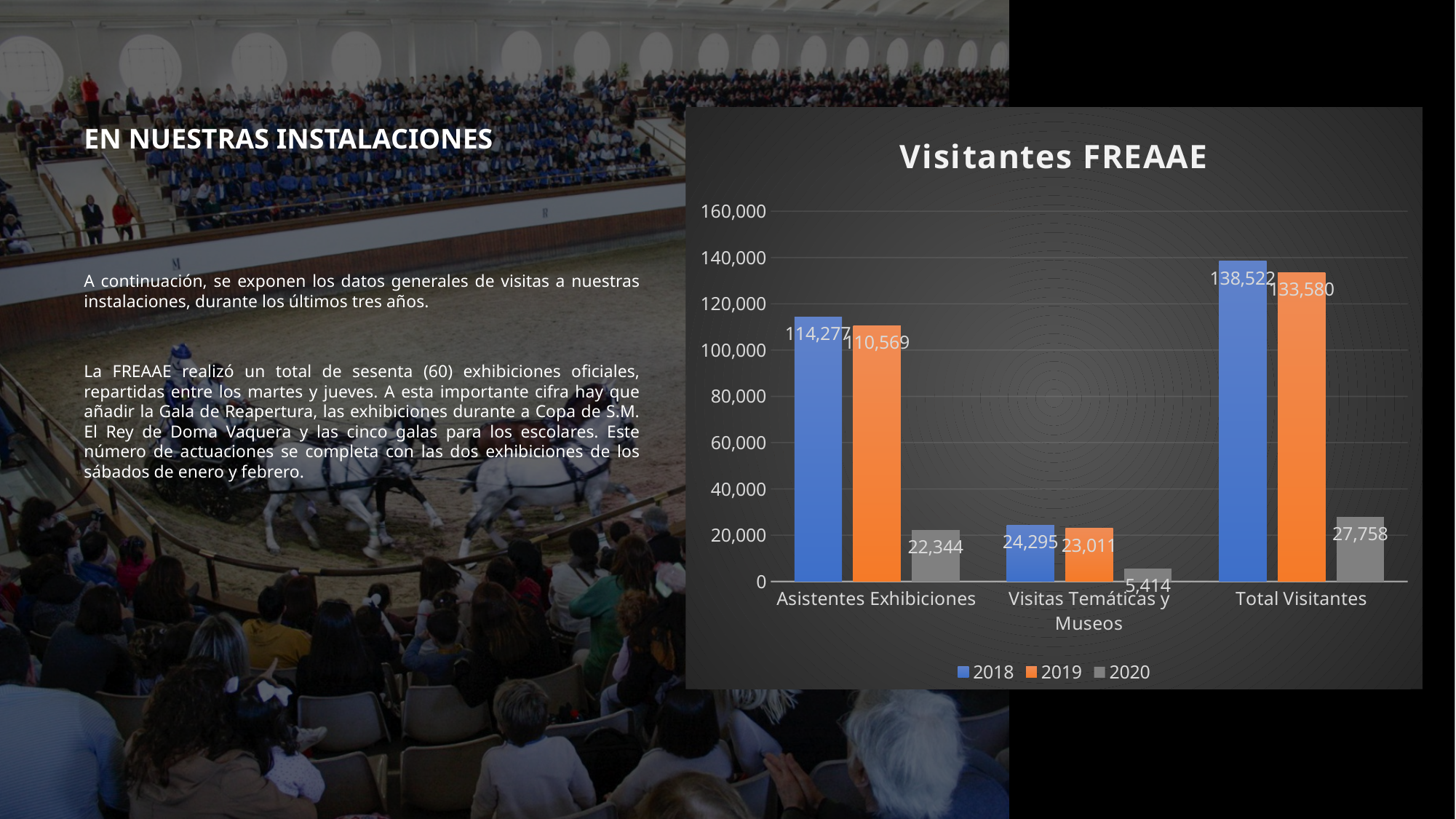
How many categories are shown on the x axis of the chart? 3 Which year has the highest value in the Total Visitantes category? 2018 What is the value for 2018 in the Asistentes Exhibiciones category? 114,277 Which category has the lowest value for the 2020 series? Visitas Temáticas y Museos What is the title of the chart? Visitantes FREAAE What is the value for 2019 in the Total Visitantes category? 133,580 What is the difference between the 2018 and 2019 values for Total Visitantes? 4,942 Which is larger: the 2018 value or the 2019 value for Visitas Temáticas y Museos? 2018 What type of chart is shown on the slide? bar chart What is the value for 2020 in the Visitas Temáticas y Museos category? 5,414 How many series does the chart legend list? 3 Is the 2020 value for Total Visitantes greater or less than 40,000? less